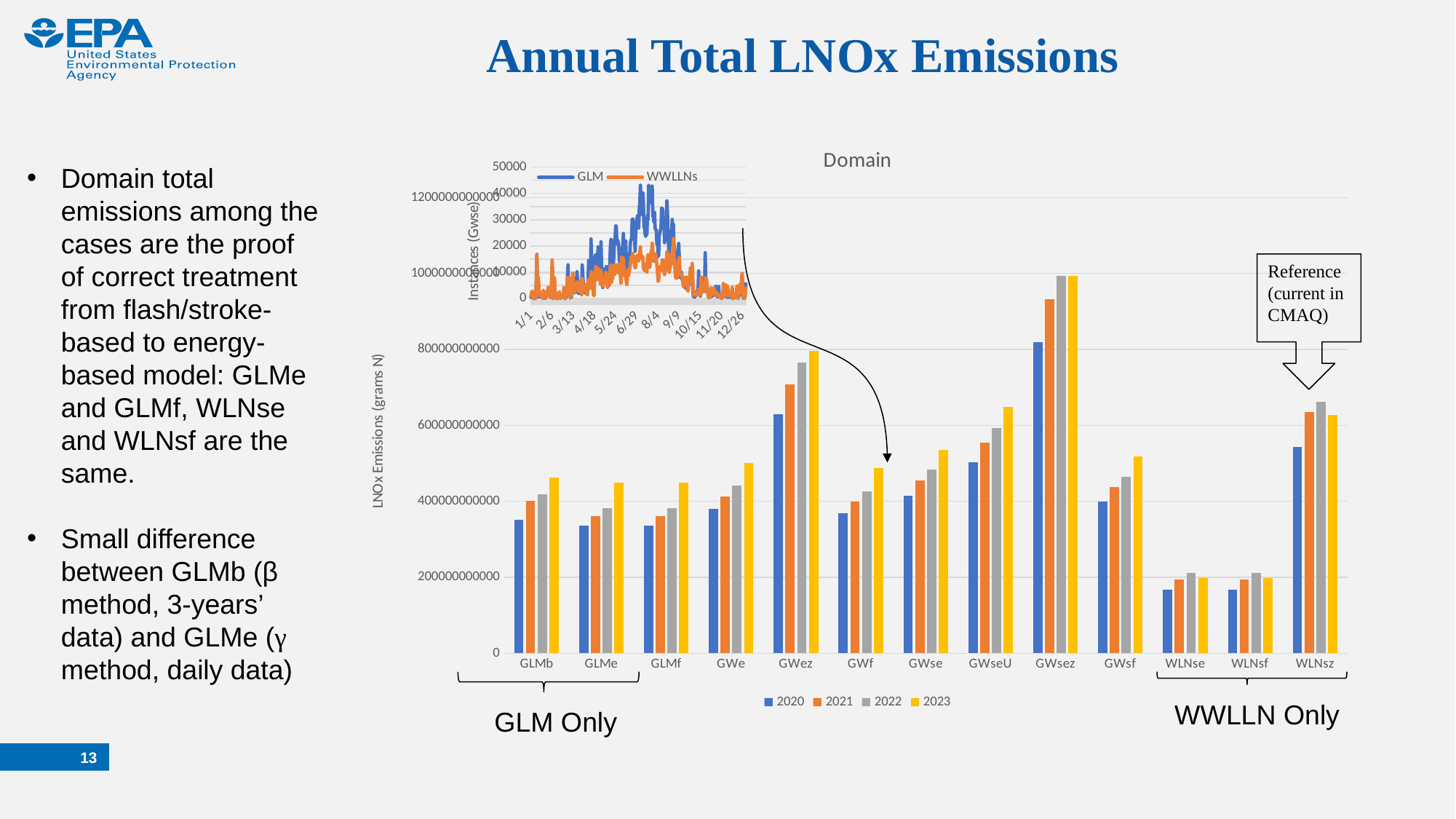
On the bar chart titled "Domain", how many categories are shown on the x axis? 13 What kind of chart is the small inset chart in the upper left of the main chart? line chart On the bar chart titled "Domain", which is larger: the 2023 value for GWse or the 2023 value for GWf? GWse On the bar chart titled "Domain", is the 2023 value for GWsez greater or less than 800000000000? greater On the bar chart titled "Domain", is the 2022 value for WLNsz greater or less than 600000000000? greater On the bar chart titled "Domain", do the values for GLMb rise or fall from 2020 to 2023? rise On the bar chart titled "Domain", is the 2020 value for GLMb greater or less than 400000000000? less On the inset line chart, which series reaches the higher peak, GLM or WWLLNs? GLM On the bar chart titled "Domain", how many series does the legend list? 4 On the bar chart titled "Domain", which is larger: the 2020 value for WLNsz or the 2020 value for GWsf? WLNsz On the bar chart titled "Domain", which category has the highest bars? GWsez